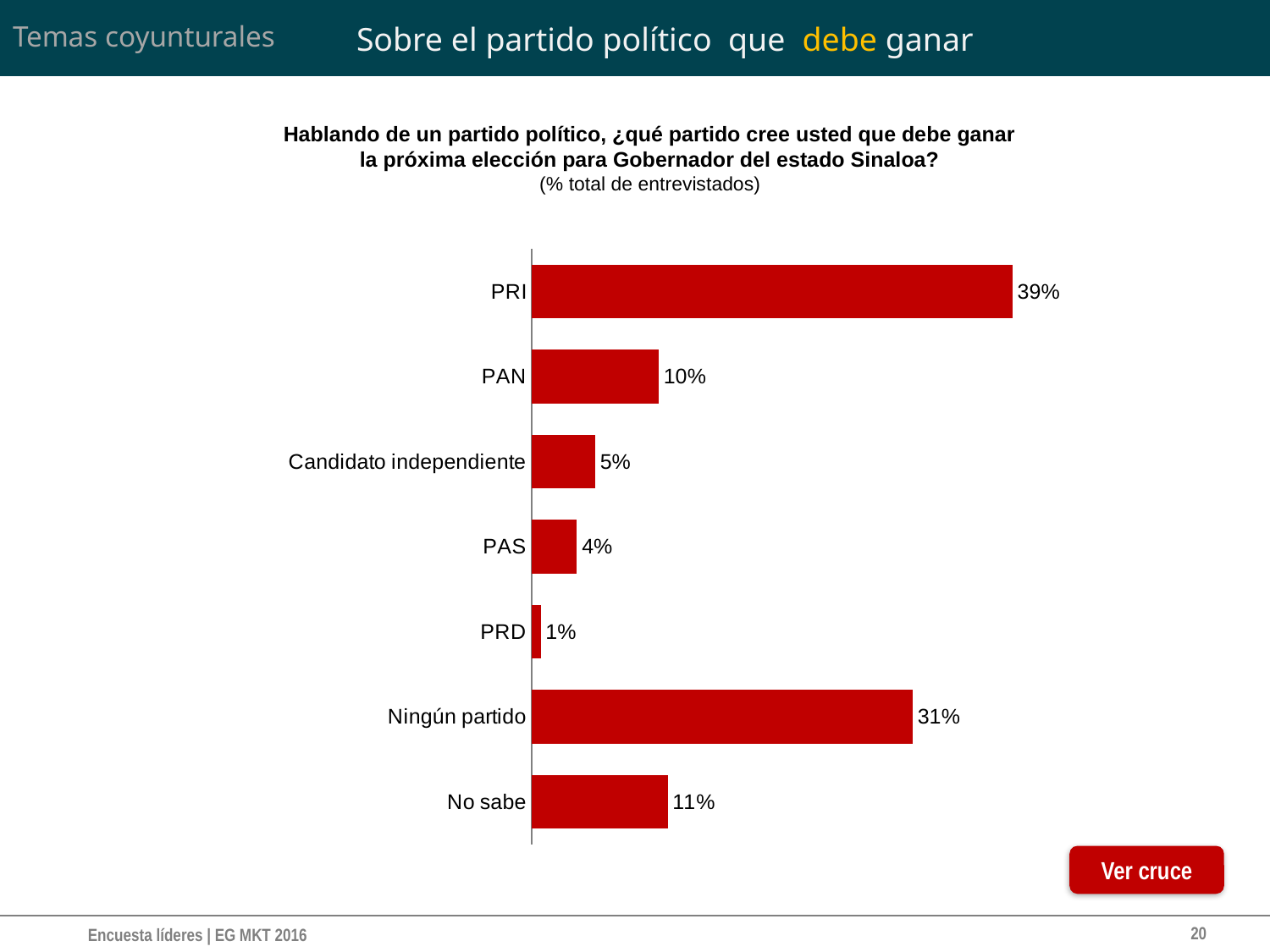
What is the value for PRI? 39% Which category has the highest value? PRI What colour are the bars in the chart? Red Which category has the lowest value? PRD What kind of chart is shown on the slide? Bar chart What is the value for No sabe? 11% What is the difference between the values for PAN and PAS? 6% What is the difference between the values for PRI and Ningún partido? 8% How many categories are shown in the chart? 7 What is the value for Candidato independiente? 5% Which is larger, the value for PAN or the value for No sabe? No sabe What is the value for Ningún partido? 31%